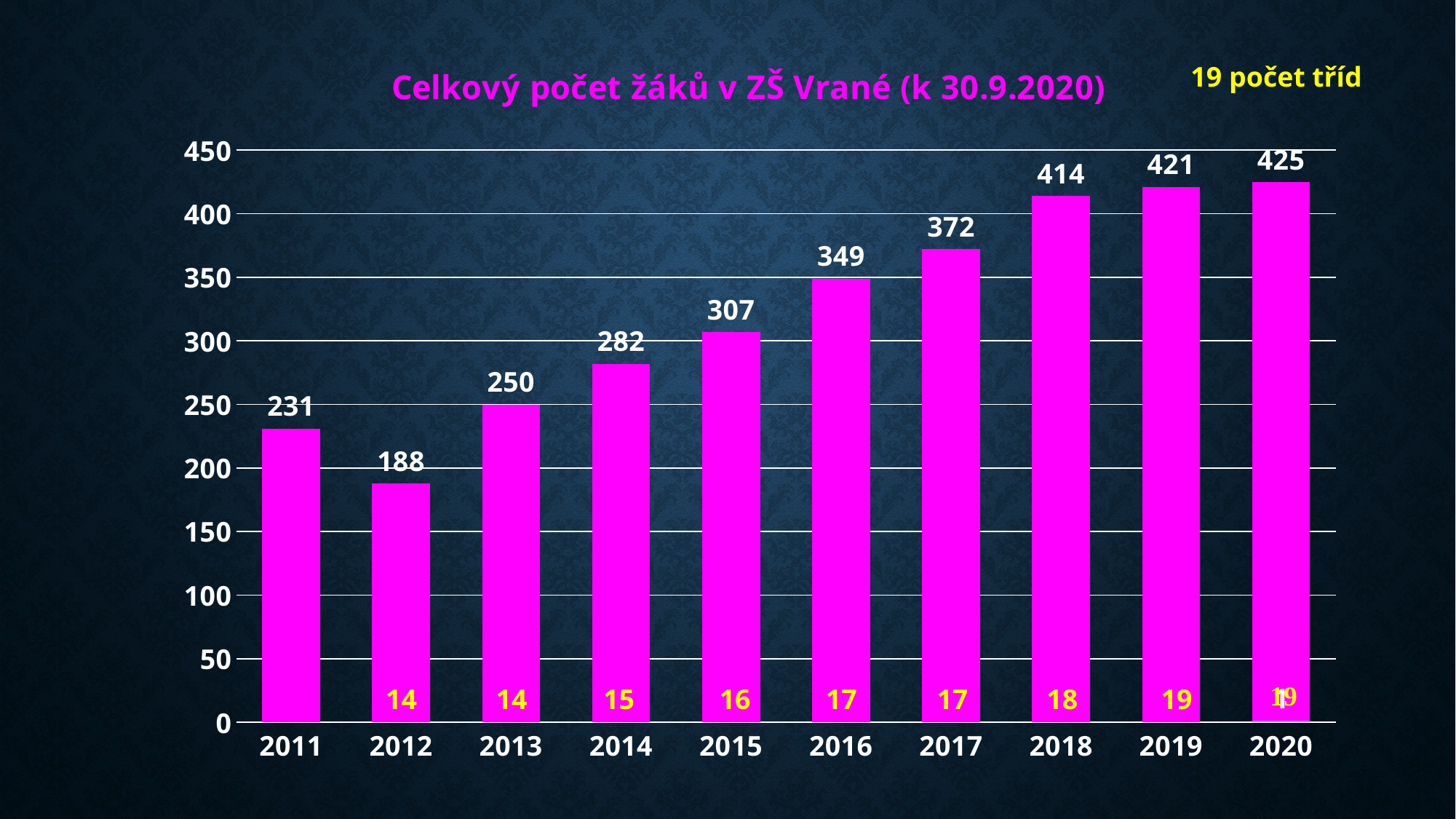
Which year has the highest number of pupils? 2020 What is the total number of pupils shown for 2015? 307 What is the title of the chart? Celkový počet žáků v ZŠ Vrané (k 30.9.2020) Which year has a larger value, 2014 or 2016? 2016 Which year has the lowest number of pupils? 2012 What kind of chart is shown on the slide? bar chart What is the value of the bar for 2012? 188 What is the difference between the values for 2020 and 2011? 194 How many years are shown on the x axis? 10 Is the value for 2013 greater or less than 300? less By how much did the number of pupils increase from 2017 to 2018? 42 Do the values generally rise or fall from 2012 to 2020? rise